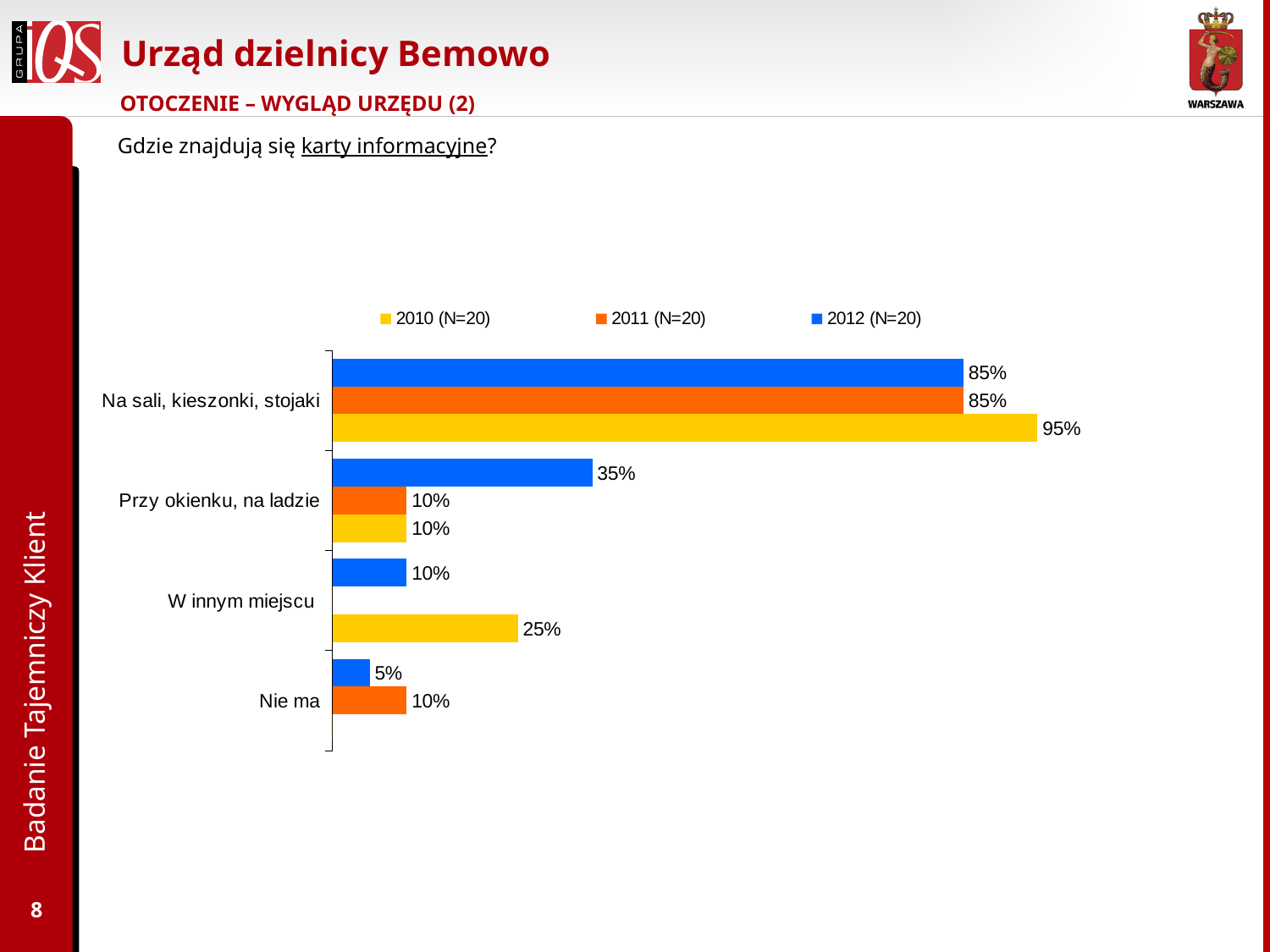
What is the value for 'Na sali, kieszonki, stojaki' in the 2010 (N=20) series? 95% Which category has the highest value in the 2011 (N=20) series? Na sali, kieszonki, stojaki What kind of chart is shown on the slide? Bar chart What is the value for 'Nie ma' in the 2012 (N=20) series? 5% Which is larger for 'Przy okienku, na ladzie': the 2012 (N=20) value or the 2011 (N=20) value? 2012 (N=20) What colour represents the 2011 (N=20) series in the chart? Orange Which category has the lowest value in the 2012 (N=20) series? Nie ma How many series does the legend list? 3 How many categories are shown on the chart? 4 What is the value for 'Przy okienku, na ladzie' in the 2012 (N=20) series? 35% What is the difference between the 2010 (N=20) and 2012 (N=20) values for 'Na sali, kieszonki, stojaki'? 10% What is the value for 'W innym miejscu' in the 2010 (N=20) series? 25%